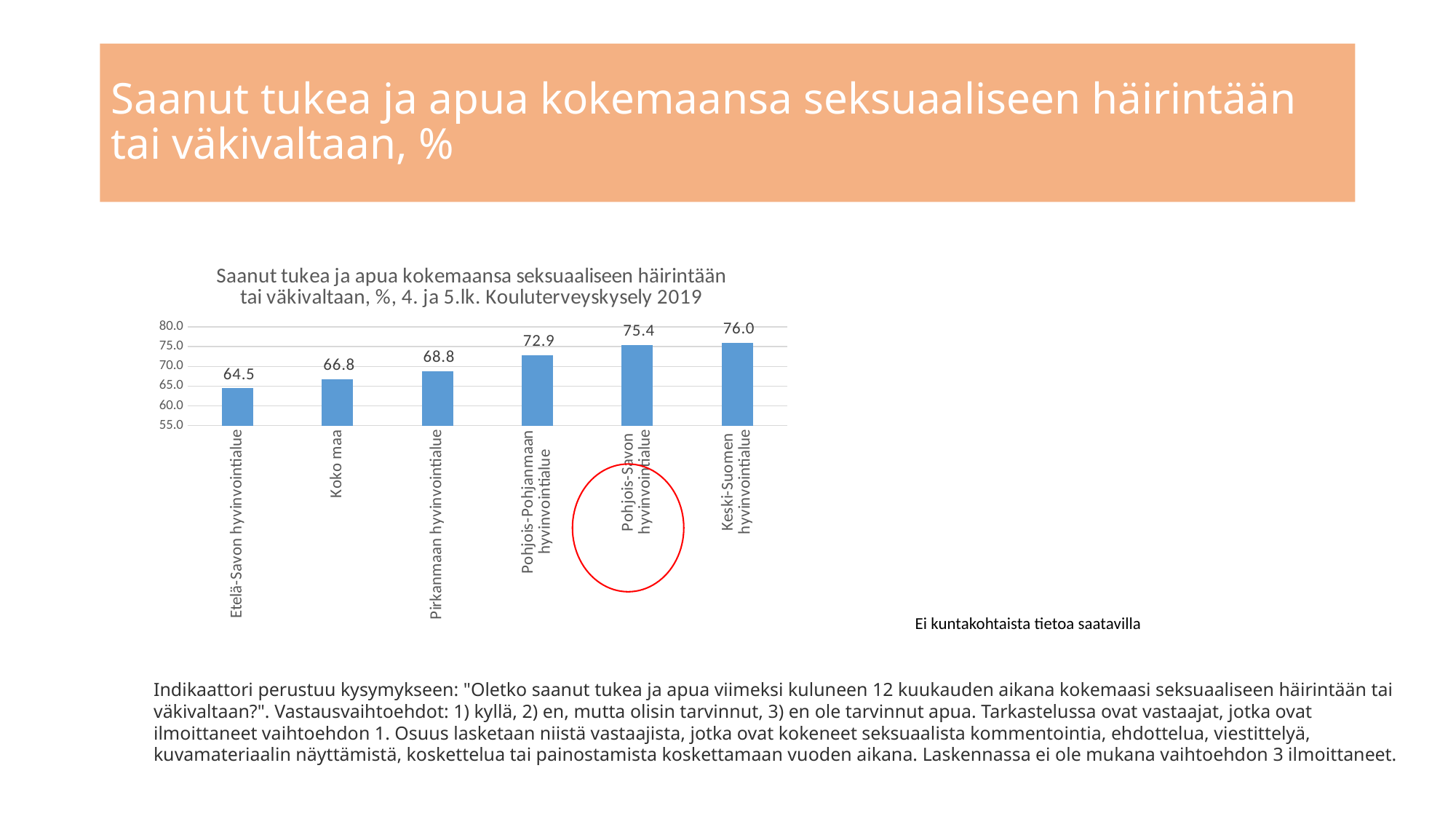
What is the difference between the values for Pohjois-Savon hyvinvointialue and Koko maa? 8.6 Do the values rise or fall from left to right along the x axis? rise Which is larger, the value for Pohjois-Pohjanmaan hyvinvointialue or the value for Pirkanmaan hyvinvointialue? Pohjois-Pohjanmaan hyvinvointialue What kind of chart is shown on the slide? bar chart What is the value for Pirkanmaan hyvinvointialue? 68.8 Is the value for Etelä-Savon hyvinvointialue greater or less than 65.0? less Which category has the lowest value? Etelä-Savon hyvinvointialue What is the value for Koko maa? 66.8 What is the value for Pohjois-Savon hyvinvointialue? 75.4 Which category has the highest value? Keski-Suomen hyvinvointialue How many categories are shown in the chart? 6 What is the difference between the values for Keski-Suomen hyvinvointialue and Etelä-Savon hyvinvointialue? 11.5